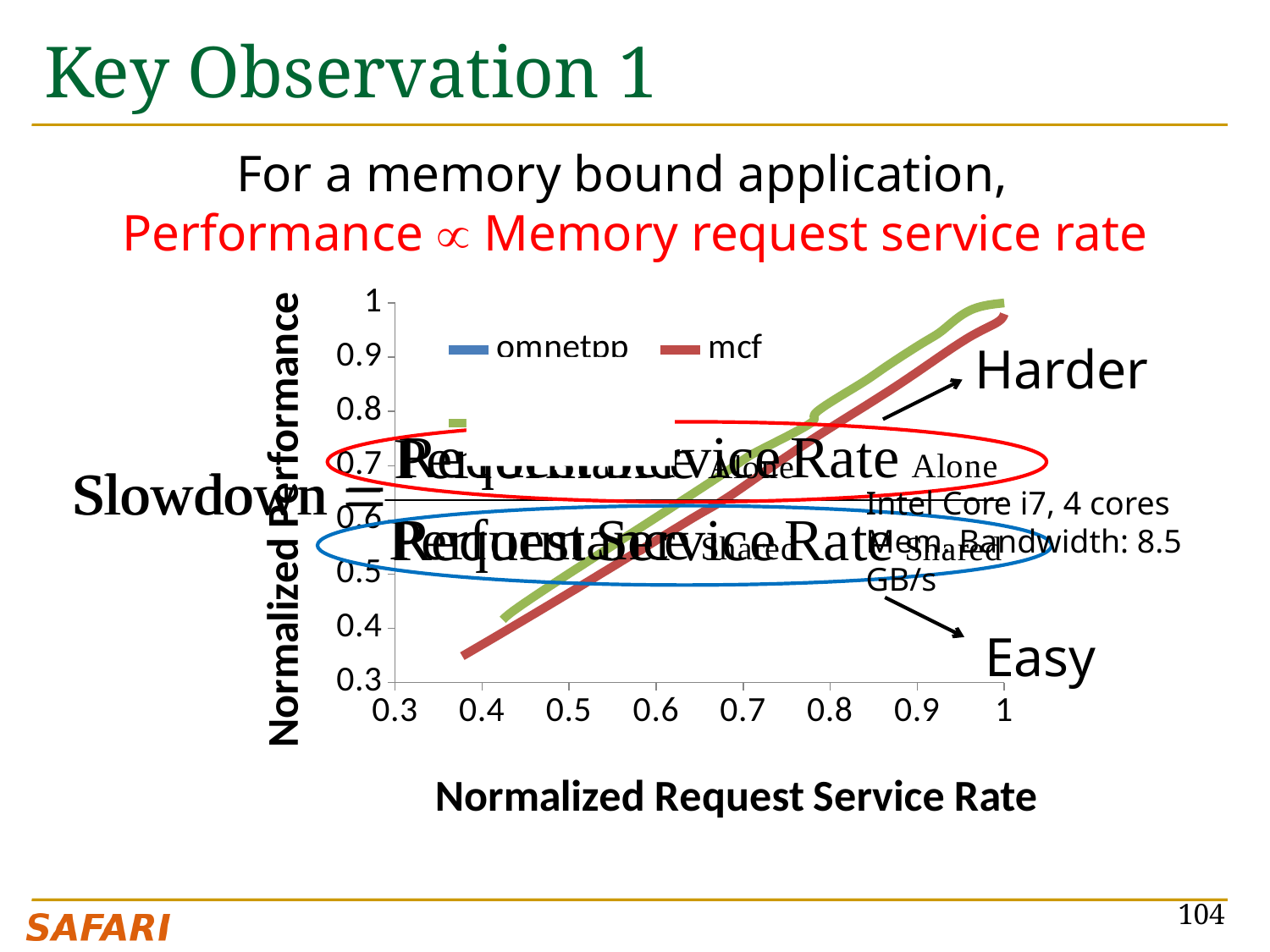
Is the normalized performance of omnetpp at a normalized request service rate of 0.5 greater or less than 0.7? less At a normalized request service rate of 0.7, which series has the higher normalized performance, omnetpp or mcf? omnetpp Is the lowest plotted normalized performance of mcf greater or less than 0.4? less What kind of chart is shown on the slide? line chart As the normalized request service rate increases along the x axis, does the normalized performance of omnetpp rise or fall? rise What is the title of the chart's x axis? Normalized Request Service Rate As the normalized request service rate increases along the x axis, does the normalized performance of mcf rise or fall? rise How many series does the chart's legend list? 3 What is the lowest value shown on the chart's x axis? 0.3 Is the normalized performance of mcf at a normalized request service rate of 1 greater or less than 0.9? greater